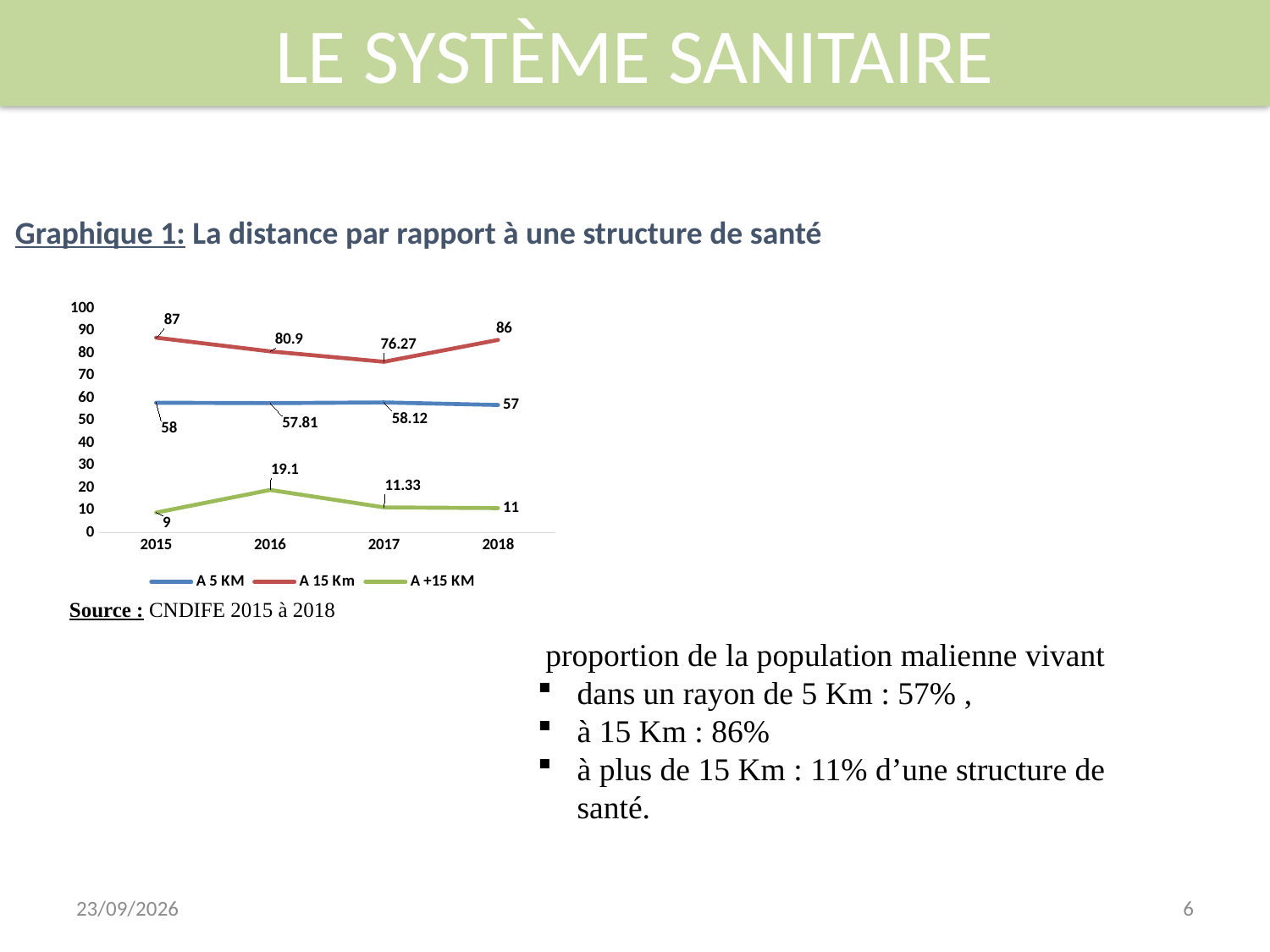
What is the value for A 15 Km in 2015? 87 How many series does the legend list? 3 Does the A 15 Km series rise or fall from 2015 to 2017? fall What colour is the line for A +15 KM? green What is the value for A +15 KM in 2016? 19.1 In which year is the A 15 Km series lowest? 2017 What kind of chart is shown? line chart In which year is the A +15 KM series highest? 2016 How many years are shown on the x axis? 4 What is the difference between the A 15 Km values in 2015 and 2017? 10.73 Which is larger in 2018, the value for A 5 KM or the value for A +15 KM? A 5 KM What is the value for A 5 KM in 2017? 58.12